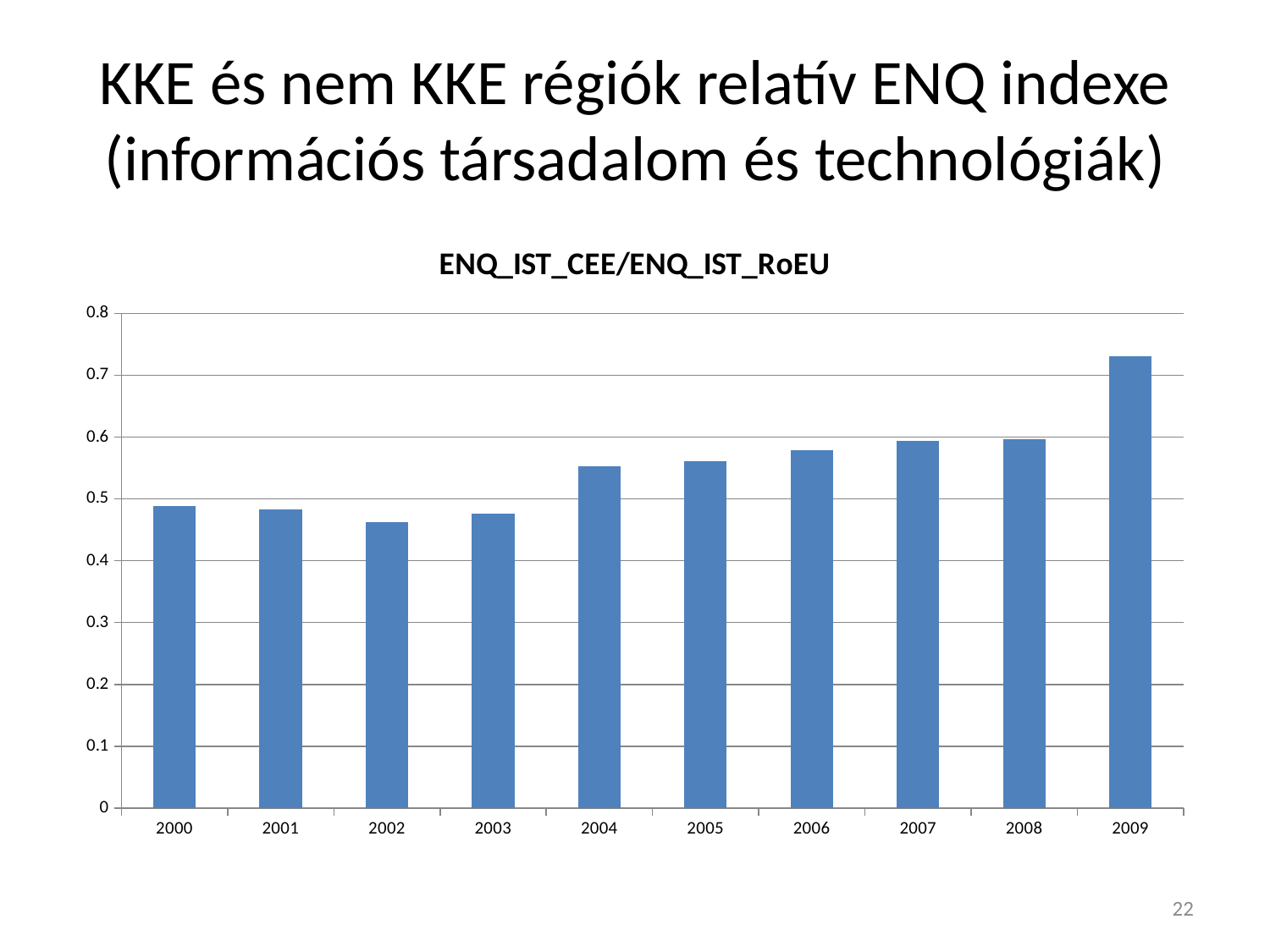
Which is larger, the value for 2000 or the value for 2009? 2009 Which year has the lowest value in the chart? 2002 Is the value for 2006 greater or less than 0.5? greater What is the title of the chart? ENQ_IST_CEE/ENQ_IST_RoEU Which year has the highest value in the chart? 2009 How many years are shown on the x axis of the chart? 10 Which is larger, the value for 2003 or the value for 2004? 2004 Do the values generally rise or fall from 2003 to 2009? rise Is the value for 2002 greater or less than 0.5? less Is the value for 2004 greater or less than 0.6? less What type of chart is shown on the slide? bar chart